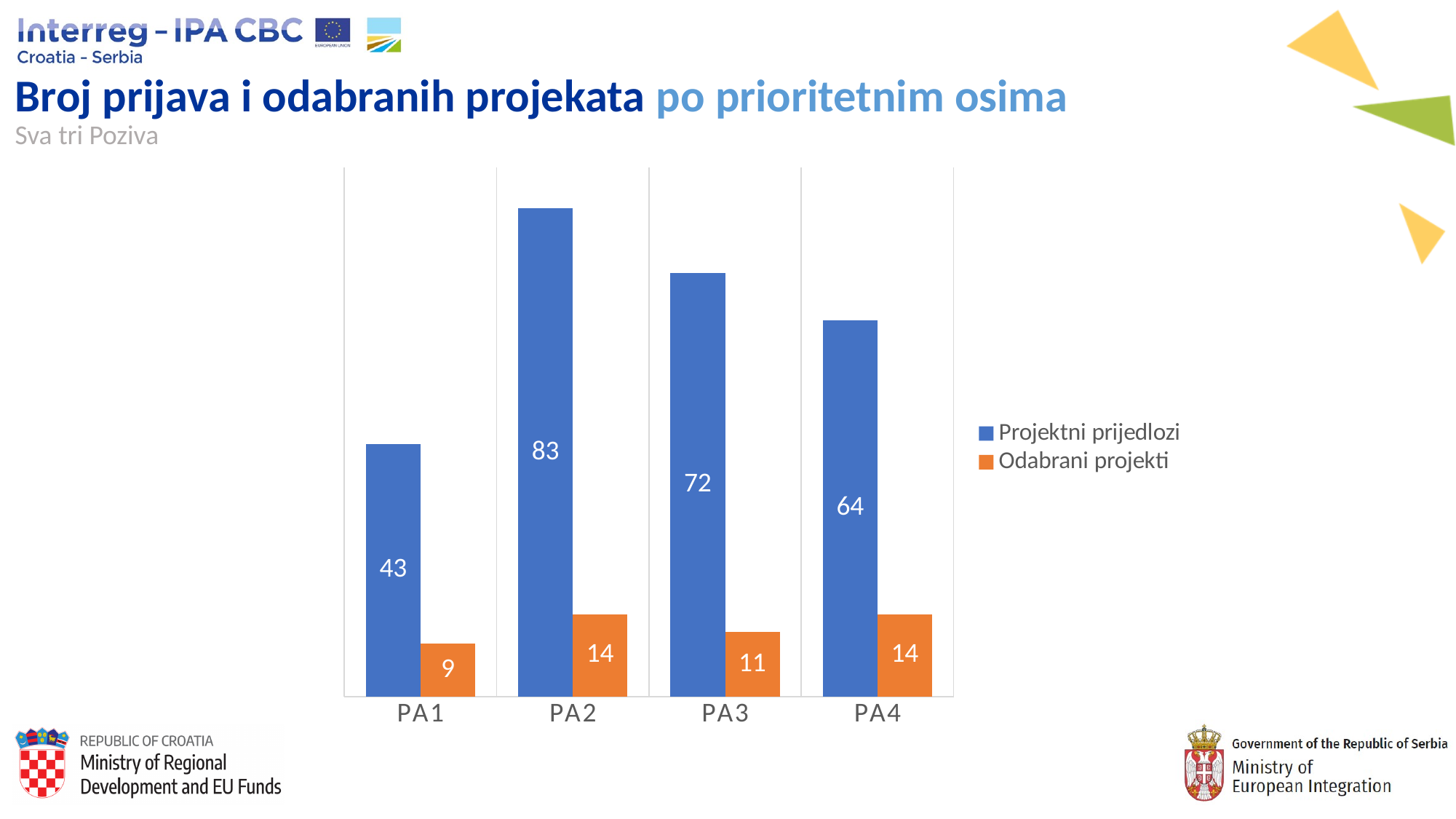
How many categories are shown on the x axis? 4 What is the difference between the Projektni prijedlozi values for PA2 and PA1? 40 What kind of chart is shown on the slide? Bar chart How many series does the legend list? 2 Which category has the lowest value for Odabrani projekti? PA1 What is the value of Odabrani projekti for PA3? 11 Which colour represents Odabrani projekti in the chart? Orange What is the value of Projektni prijedlozi for PA2? 83 Which is larger, Projektni prijedlozi for PA3 or for PA4? PA3 What is the value of Odabrani projekti for PA1? 9 What is the difference between Projektni prijedlozi and Odabrani projekti for PA4? 50 Which category has the highest value for Projektni prijedlozi? PA2